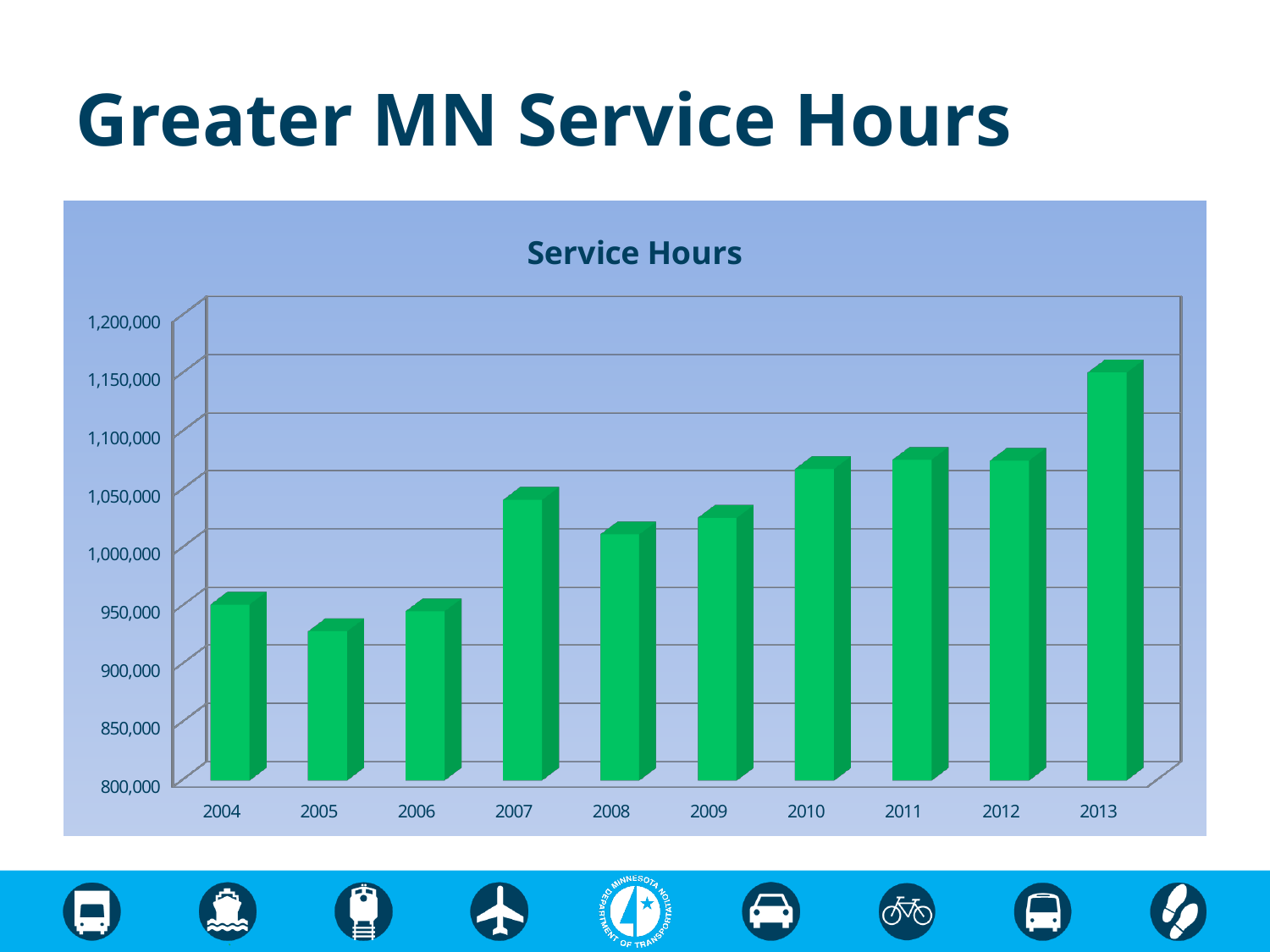
Is the value for 2007 greater or less than 1,000,000? greater Is the value for 2009 greater or less than 1,050,000? less Which year has the lowest service hours? 2005 Is the value for 2005 greater or less than 950,000? less Do service hours generally rise or fall from 2004 to 2013? rise What kind of chart is shown on the slide? bar chart What is the title of the chart? Service Hours Which year has the highest service hours? 2013 Which year has more service hours, 2007 or 2008? 2007 How many years are shown on the x axis of the chart? 10